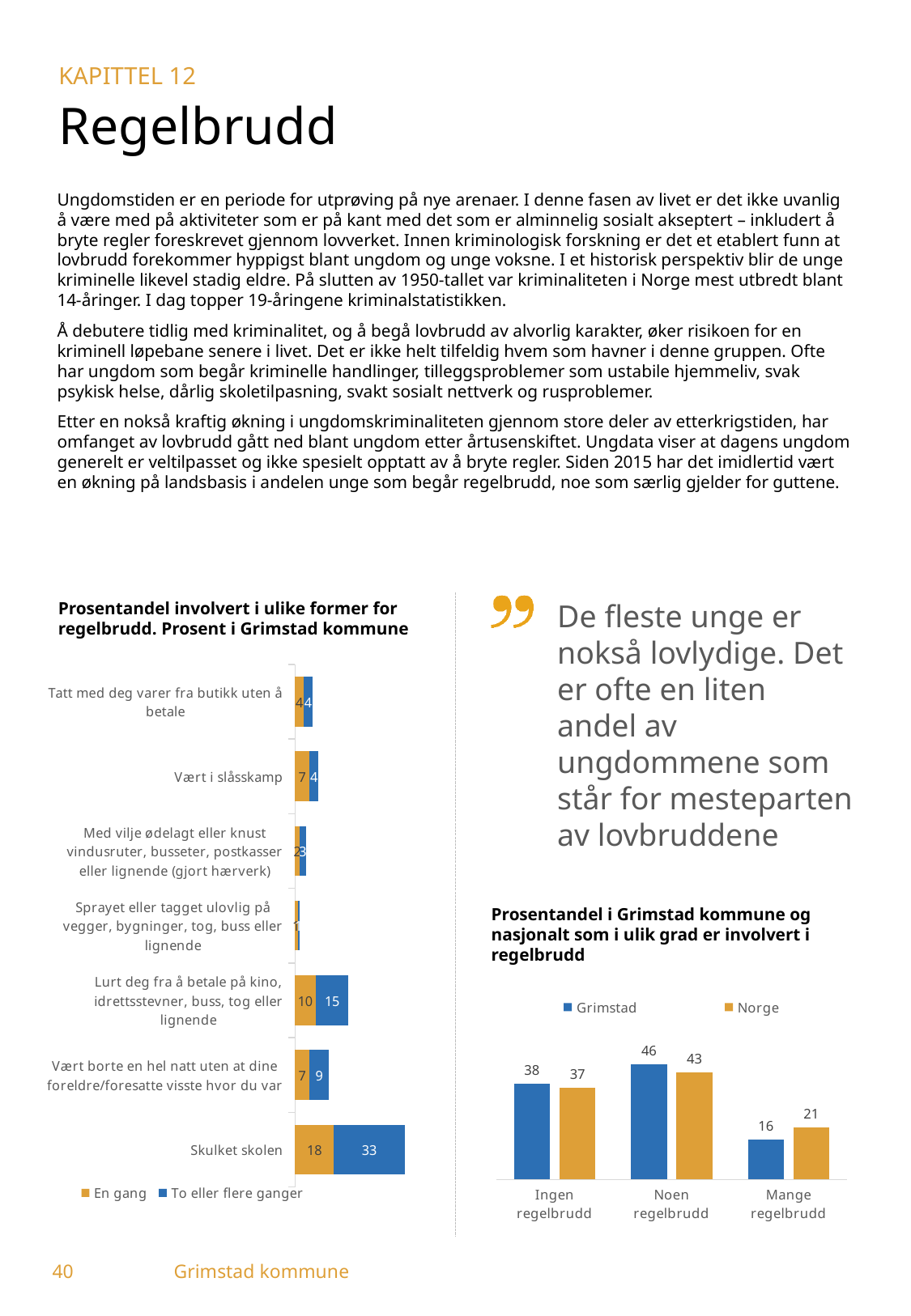
How many series does the legend list in the chart 'Prosentandel i Grimstad kommune og nasjonalt som i ulik grad er involvert i regelbrudd'? 2 In the chart 'Prosentandel i Grimstad kommune og nasjonalt som i ulik grad er involvert i regelbrudd', what is the difference between Norge and Grimstad in the 'Mange regelbrudd' category? 5 In the chart 'Prosentandel involvert i ulike former for regelbrudd. Prosent i Grimstad kommune', what is the value of 'To eller flere ganger' for 'Skulket skolen'? 33 In the chart 'Prosentandel involvert i ulike former for regelbrudd. Prosent i Grimstad kommune', what is the total of the stacked bar for 'Skulket skolen'? 51 In the chart 'Prosentandel involvert i ulike former for regelbrudd. Prosent i Grimstad kommune', which category has the longest total bar? Skulket skolen In the chart 'Prosentandel i Grimstad kommune og nasjonalt som i ulik grad er involvert i regelbrudd', which is larger for 'Ingen regelbrudd': Grimstad or Norge? Grimstad In the chart 'Prosentandel involvert i ulike former for regelbrudd. Prosent i Grimstad kommune', what is the value of 'En gang' for 'Lurt deg fra å betale på kino, idrettsstevner, buss, tog eller lignende'? 10 In the chart 'Prosentandel i Grimstad kommune og nasjonalt som i ulik grad er involvert i regelbrudd', what is the value for Norge in the 'Mange regelbrudd' category? 21 What kind of chart is 'Prosentandel involvert i ulike former for regelbrudd. Prosent i Grimstad kommune'? Stacked horizontal bar chart In the chart 'Prosentandel i Grimstad kommune og nasjonalt som i ulik grad er involvert i regelbrudd', which category has the highest value for Grimstad? Noen regelbrudd In the chart 'Prosentandel i Grimstad kommune og nasjonalt som i ulik grad er involvert i regelbrudd', what is the value for Grimstad in the 'Noen regelbrudd' category? 46 How many categories are shown in the chart 'Prosentandel involvert i ulike former for regelbrudd. Prosent i Grimstad kommune'? 7